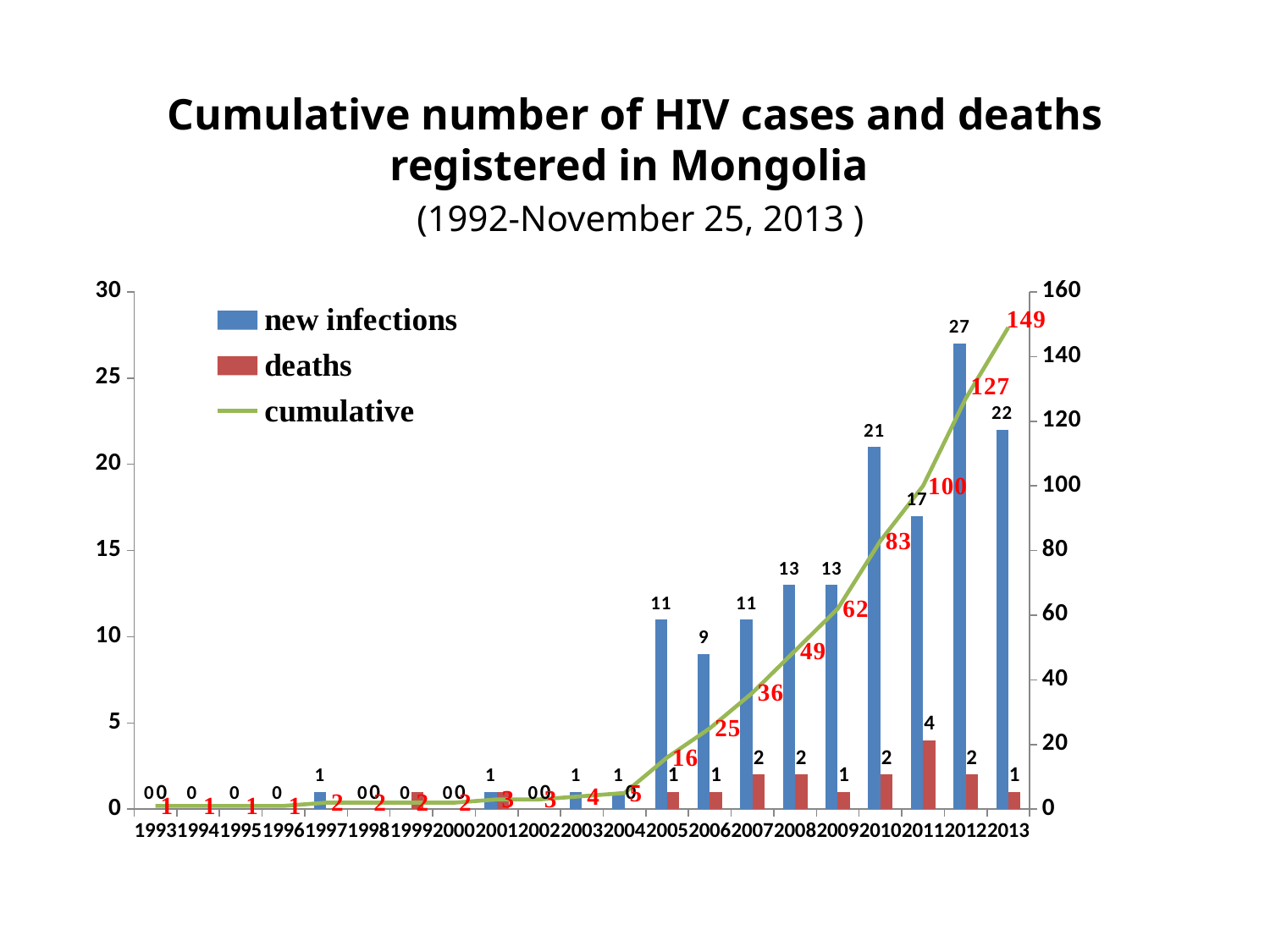
Which year had more new infections, 2010 or 2011? 2010 How many years are shown on the x axis? 21 How many series does the legend list? 3 How many deaths are shown for 2011? 4 What is the difference between new infections in 2012 and 2013? 5 Which series is drawn as a green line? cumulative What is the cumulative value shown for 2010? 83 What is the number of new infections in 2012? 27 Which year has the highest number of new infections? 2012 Does the cumulative line rise or fall from 1993 to 2013? Rises What kind of chart is shown on the slide? Combined bar and line chart What is the cumulative value shown for 2013? 149